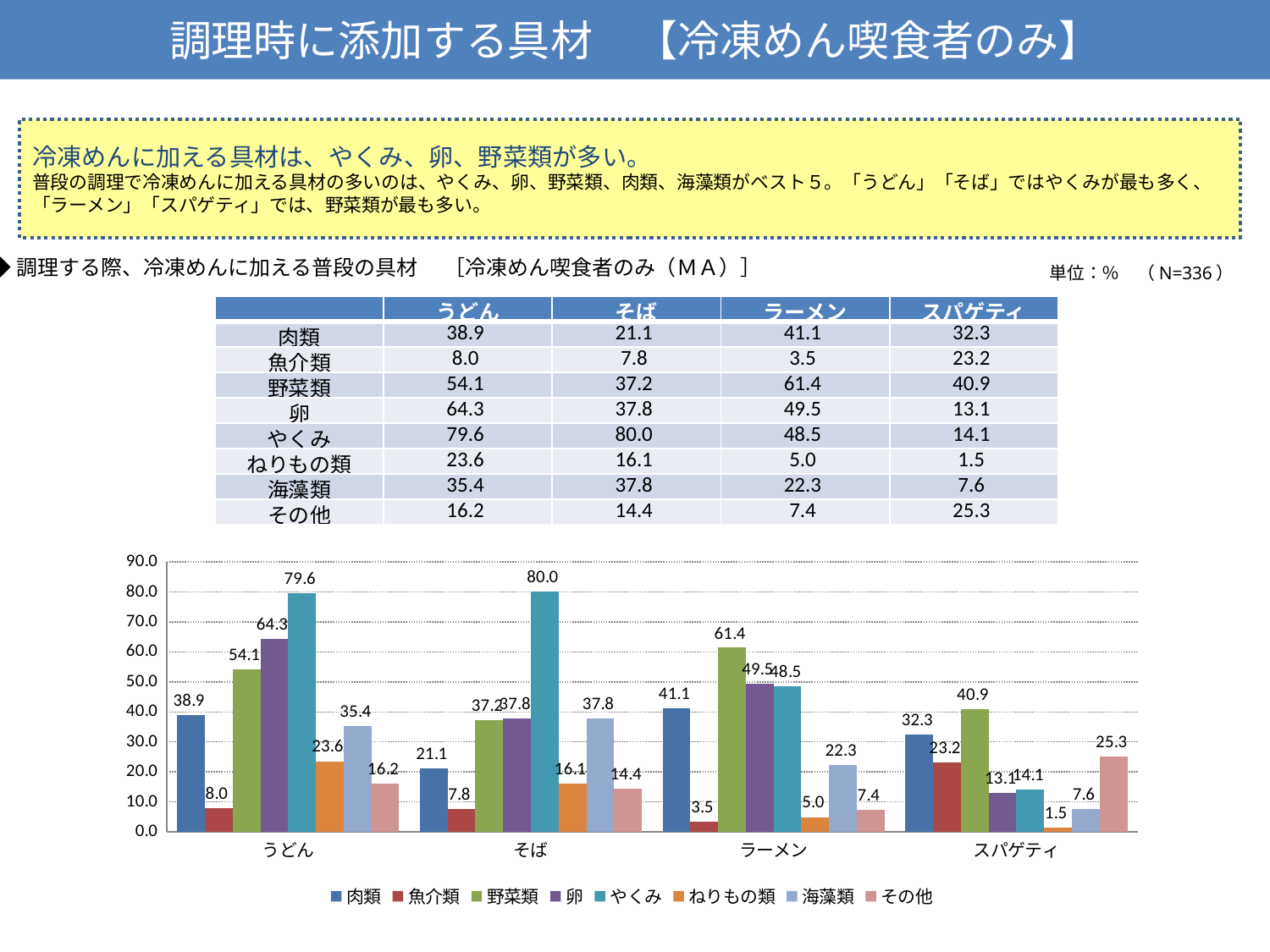
What kind of chart is shown on the slide? bar chart Which series has the highest value in the そば group? やくみ What is the value for 魚介類 in the スパゲティ group? 23.2 Which series has the lowest value in the スパゲティ group? ねりもの類 What is the difference between the 肉類 values for うどん and そば? 17.8 Which is larger, the 卵 value for うどん or for ラーメン? うどん What is the value for やくみ in the うどん group? 79.6 How many noodle categories are shown on the x axis of the chart? 4 What is the first entry in the chart legend? 肉類 How many series does the chart legend list? 8 What is the value for 野菜類 in the ラーメン group? 61.4 What is the difference between the 野菜類 values for ラーメン and スパゲティ? 20.5